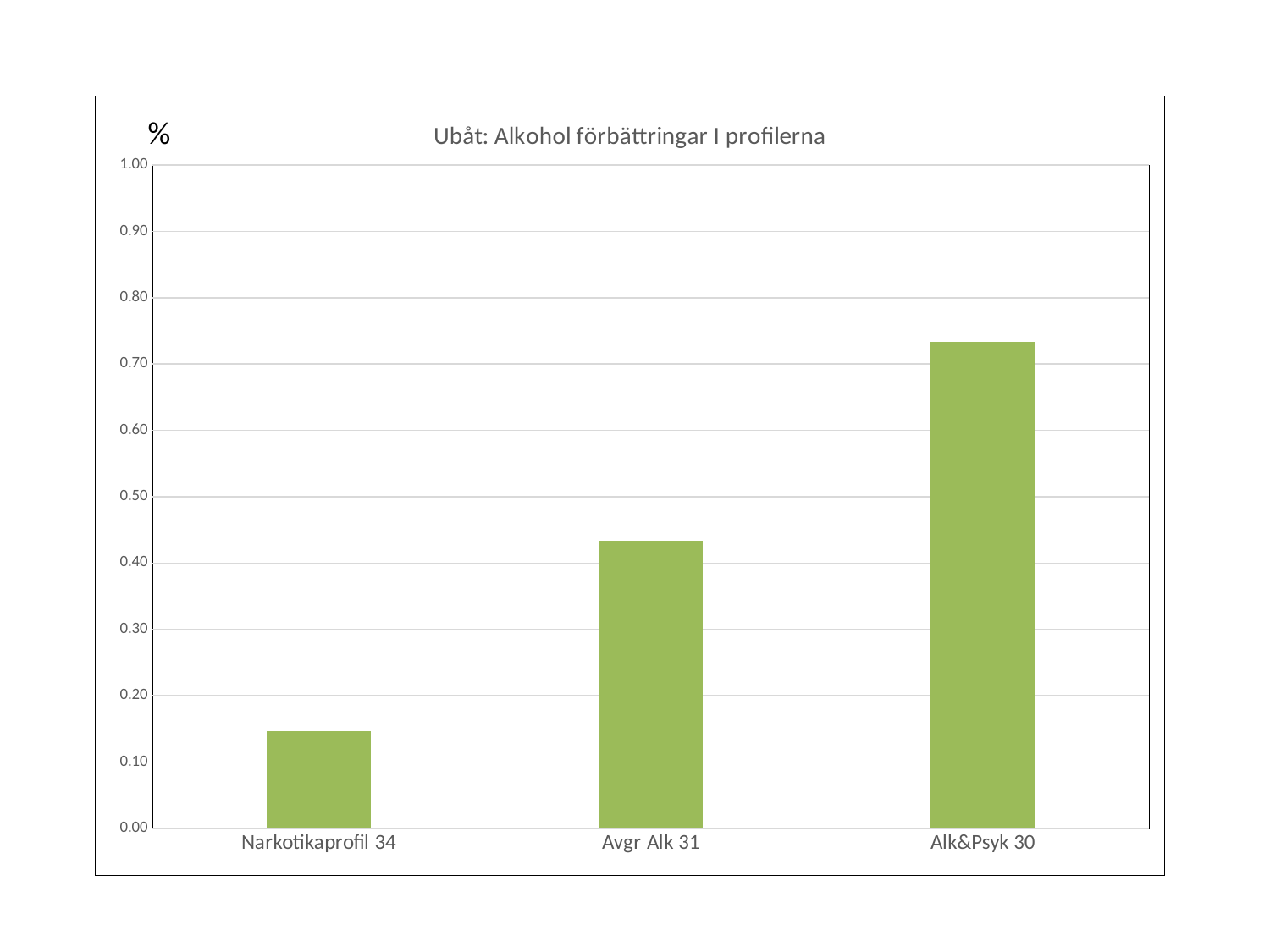
How many categories are shown on the x axis? 3 Which category has the lowest value? Narkotikaprofil 34 Which is larger, the value for Avgr Alk 31 or the value for Narkotikaprofil 34? Avgr Alk 31 Is the value for Alk&Psyk 30 greater or less than 0.70? greater Is the value for Narkotikaprofil 34 greater or less than 0.20? less What is the title of the chart? Ubåt: Alkohol förbättringar I profilerna Is the value for Avgr Alk 31 greater or less than 0.40? greater Do the values rise or fall from left to right along the x axis? rise Which category has the highest value? Alk&Psyk 30 What label is shown at the top of the vertical axis? % What kind of chart is shown on the slide? bar chart